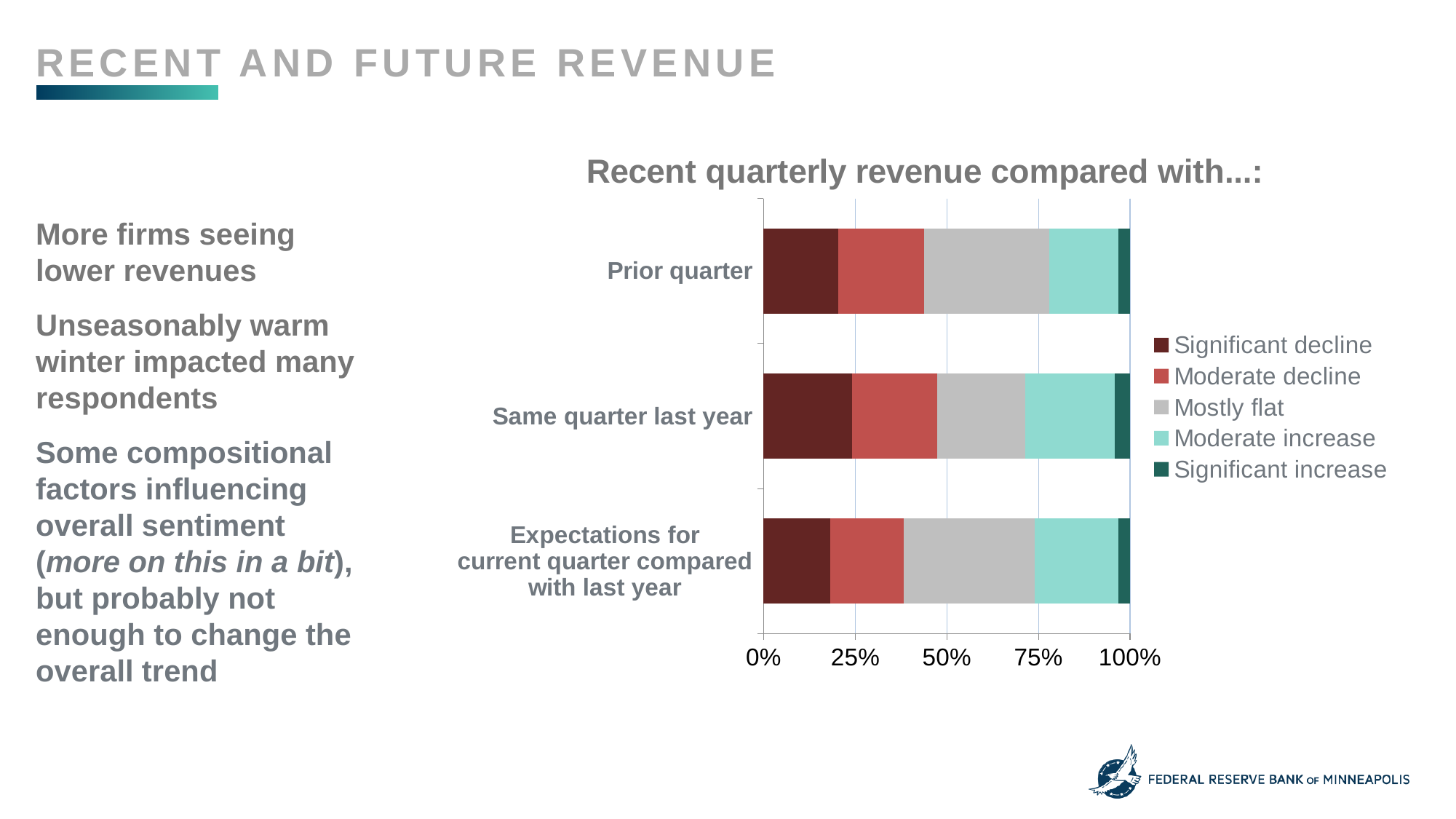
Is the Significant decline share for Prior quarter greater or less than 25%? less How many categories are plotted on the chart? 3 Which category has the larger Mostly flat share: Same quarter last year or Expectations for current quarter compared with last year? Expectations for current quarter compared with last year How many series does the chart's legend list? 5 Which legend entry is shown in light grey? Mostly flat Which category has the larger Moderate increase share: Prior quarter or Same quarter last year? Same quarter last year What kind of chart is shown on the slide? Stacked bar chart Is the Mostly flat share for Prior quarter greater or less than 25%? greater Is the Significant decline share for Expectations for current quarter compared with last year greater or less than 25%? less What is the title of the chart? Recent quarterly revenue compared with...: